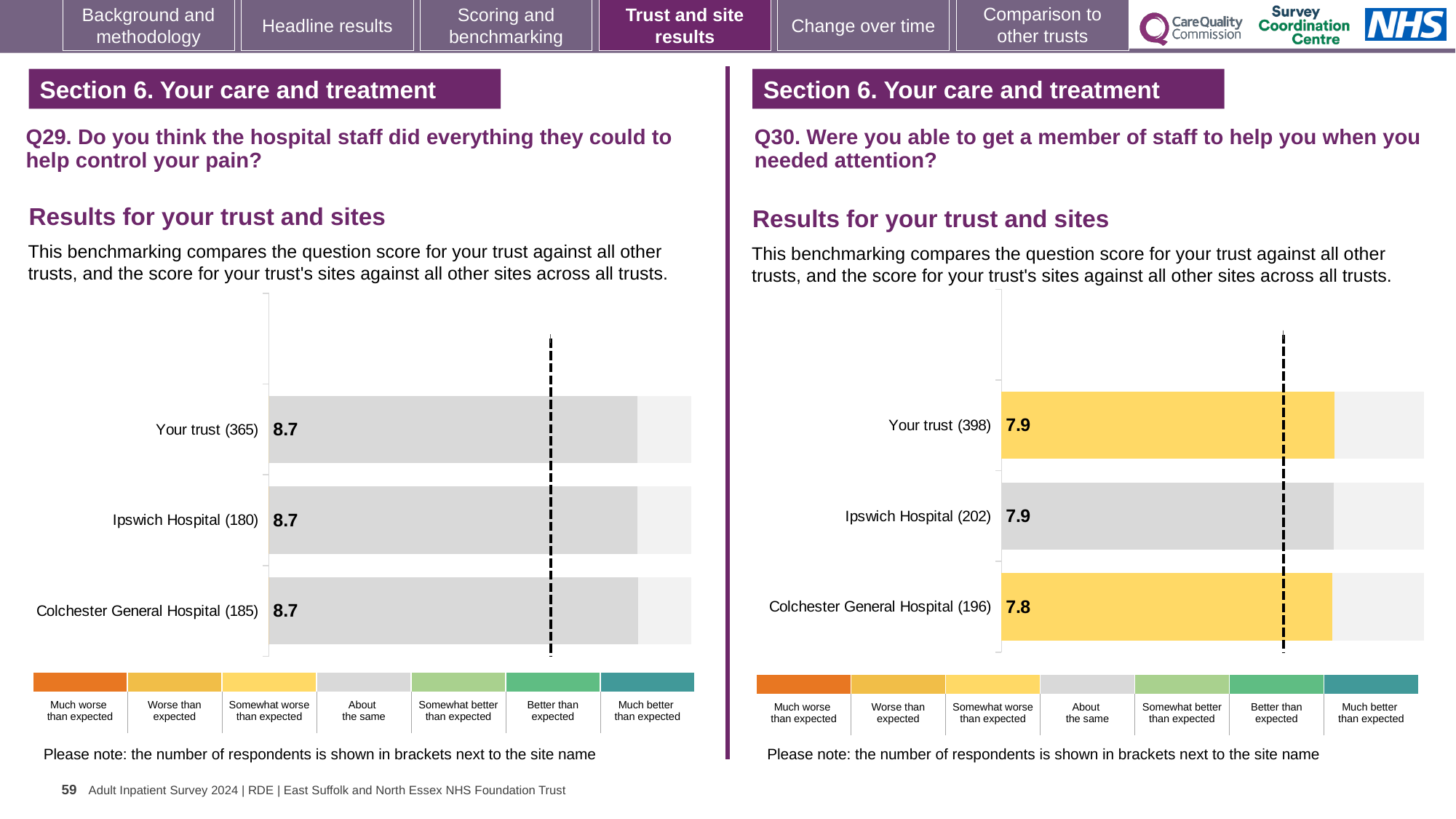
In the Q30 chart on the right, which has the larger score, Your trust (398) or Colchester General Hospital (196)? Your trust (398) In the Q30 chart on the right, what is the difference between the scores for Ipswich Hospital (202) and Colchester General Hospital (196)? 0.1 In the Q30 chart on the right, what is the score for Colchester General Hospital (196)? 7.8 How many bars are shown in the Q29 chart on the left? 3 In the Q30 chart on the right, what is the score for Your trust (398)? 7.9 What type of chart is used for the Q30 results on the right? Bar chart In the Q29 chart on the left, what is the score for Your trust (365)? 8.7 In the Q29 chart on the left, how many respondents are shown for Ipswich Hospital? 180 In the Q29 chart on the left, what is the score for Colchester General Hospital (185)? 8.7 In the Q29 chart on the left, which benchmark category does the colour of the Ipswich Hospital (180) bar correspond to? About the same In the Q30 chart on the right, which benchmark category does the colour of the Your trust (398) bar correspond to? Somewhat worse than expected In the Q30 chart on the right, which site has the lowest score? Colchester General Hospital (196)